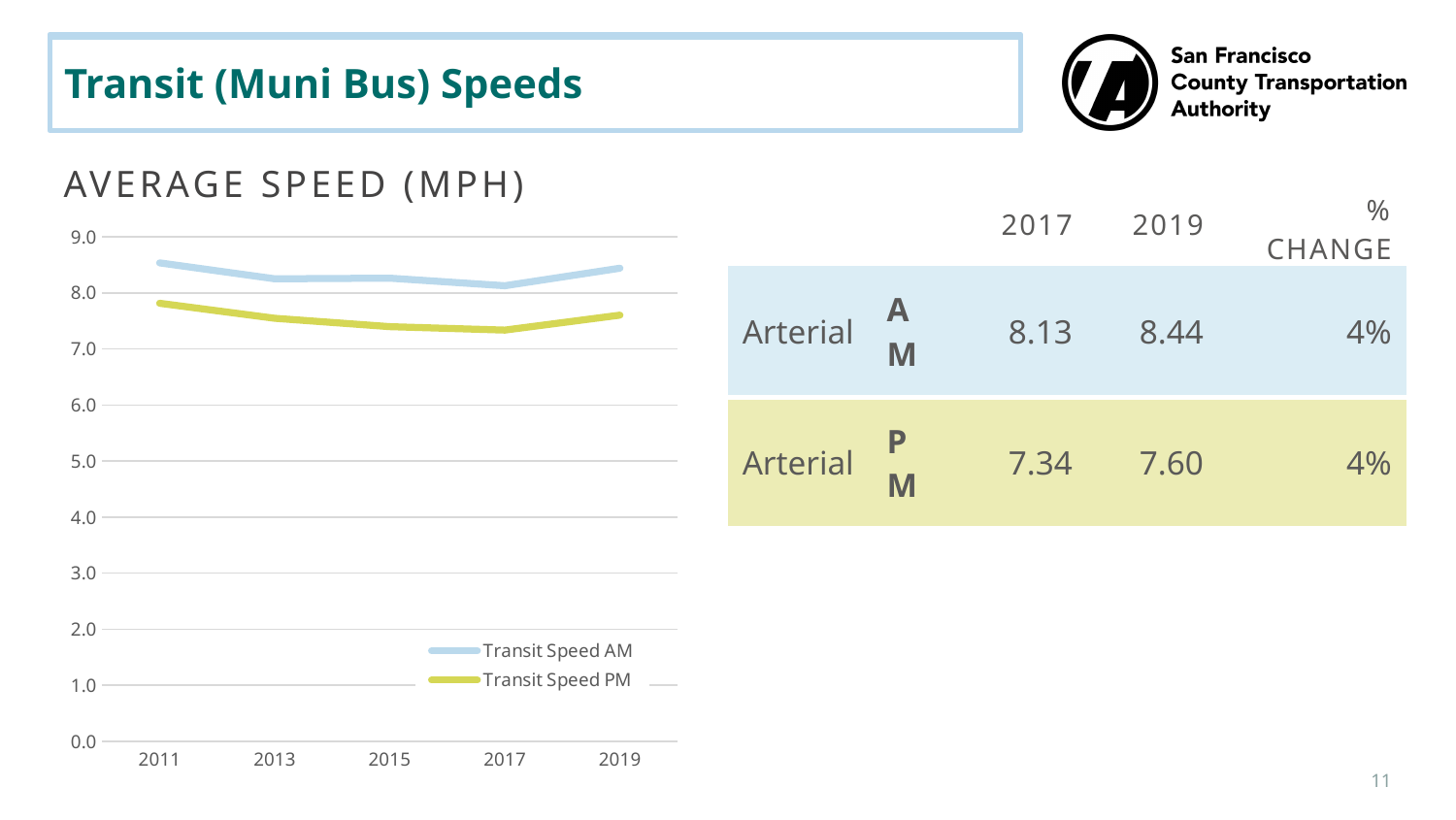
What is the Transit Speed AM value for 2017? 8.13 How many series does the chart legend list? 2 What is the Transit Speed AM value for 2019? 8.44 How many years are shown along the x axis of the chart? 5 Which series is higher in 2015, Transit Speed AM or Transit Speed PM? Transit Speed AM Is the Transit Speed PM value for 2011 greater or less than 7.0? greater Does the Transit Speed AM line rise or fall from 2017 to 2019? rise What type of chart is shown on the slide? line chart What is the Transit Speed PM value for 2017? 7.34 What is the difference between the Transit Speed PM values for 2019 and 2017? 0.26 What is the title shown above the chart? AVERAGE SPEED (MPH) Is the Transit Speed AM value for 2013 greater or less than 9.0? less